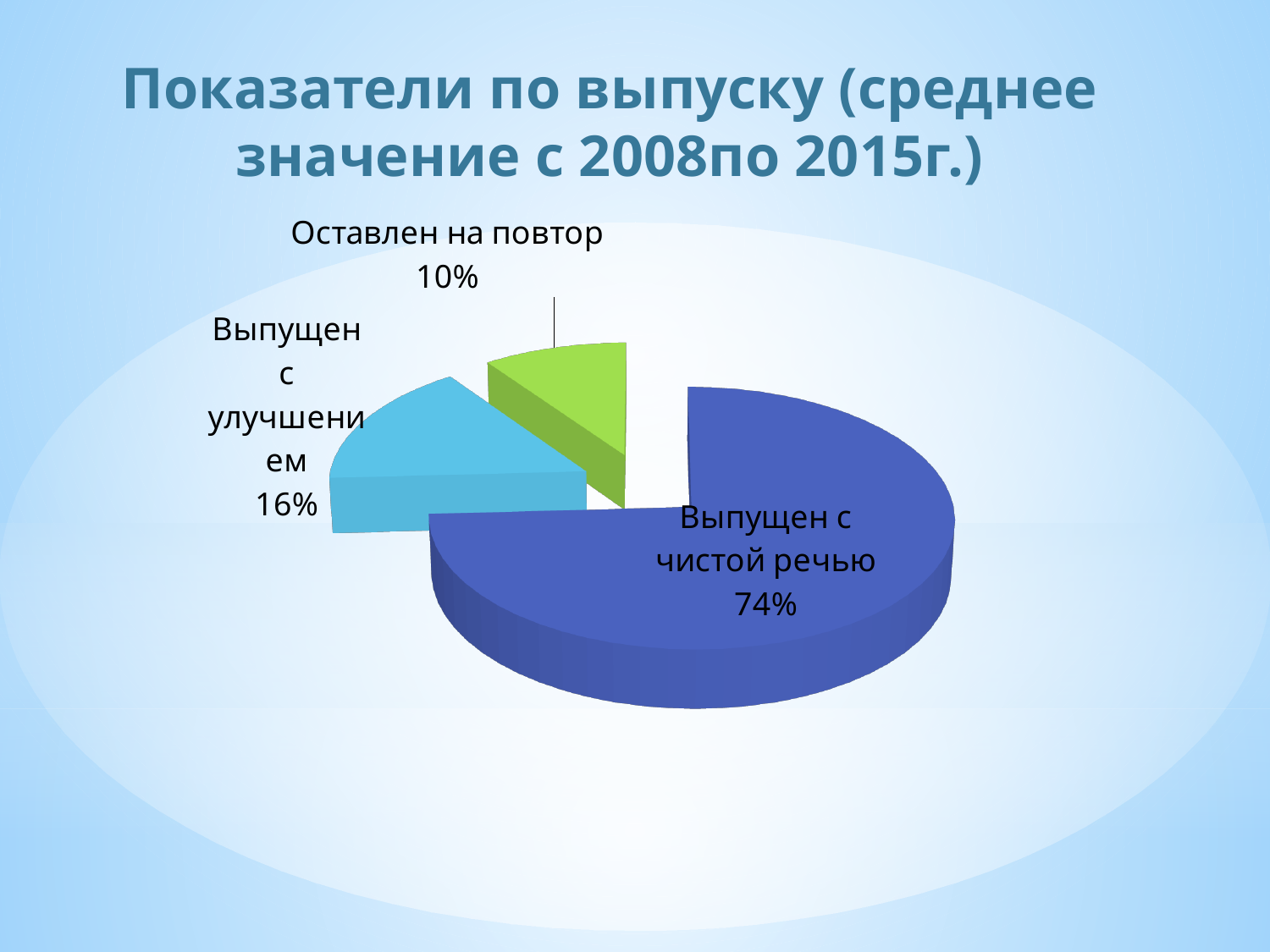
Which category has the smallest slice of the pie? Оставлен на повтор Which category has the largest slice of the pie? Выпущен с чистой речью What is the title of the slide containing the chart? Показатели по выпуску (среднее значение с 2008по 2015г.) What share of the pie is labelled "Оставлен на повтор"? 10% What is the difference in percentage points between "Выпущен с чистой речью" and "Выпущен с улучшением"? 58 Which is larger: the share for "Выпущен с улучшением" or the share for "Оставлен на повтор"? Выпущен с улучшением What kind of chart is shown on the slide? Pie chart What is the difference in percentage points between "Выпущен с улучшением" and "Оставлен на повтор"? 6 What share of the pie is labelled "Выпущен с улучшением"? 16% What colour is the slice for "Оставлен на повтор"? Green How many slices does the pie chart have? 3 What share of the pie is labelled "Выпущен с чистой речью"? 74%